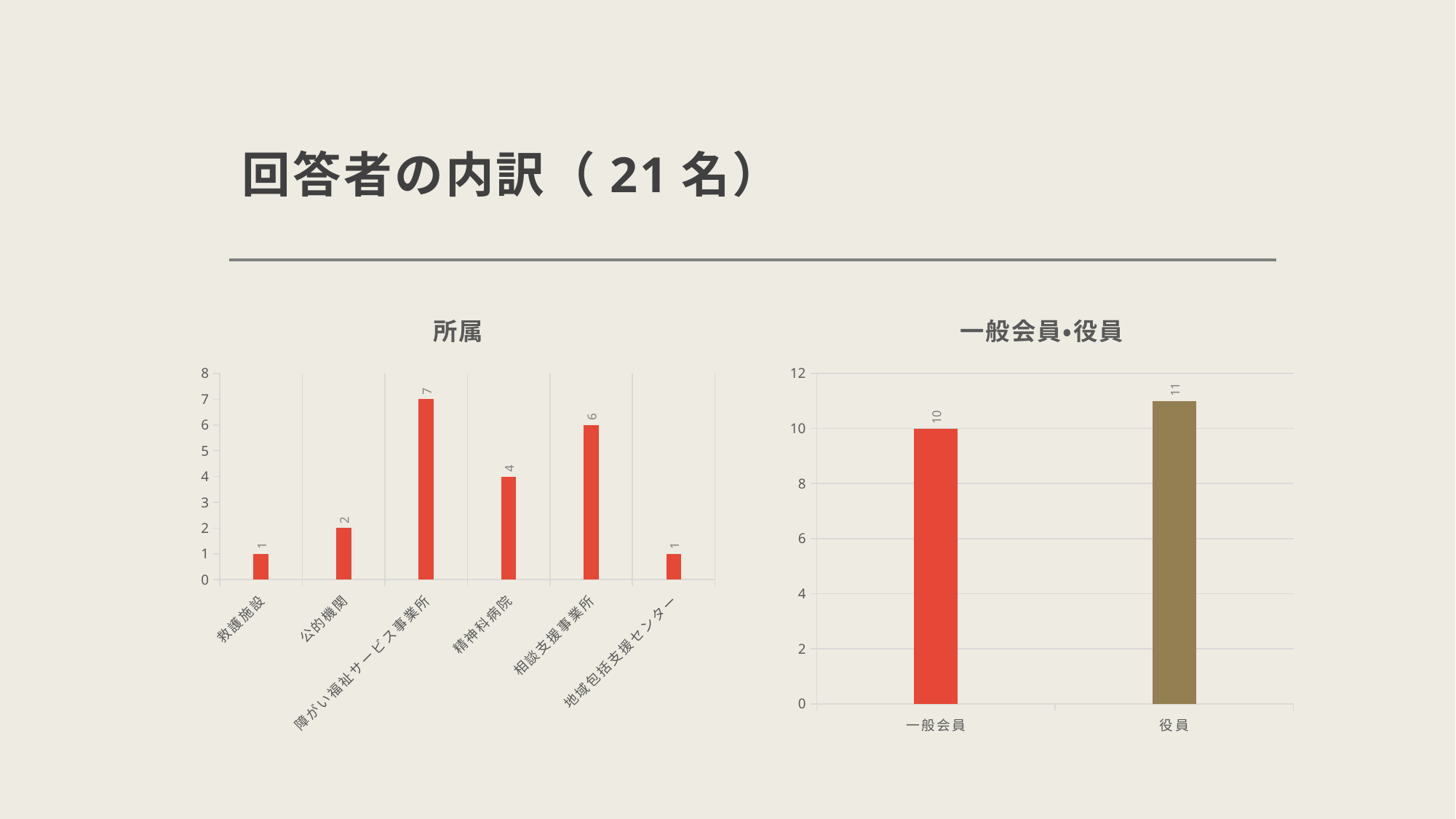
In the 所属 chart, what is the difference between 相談支援事業所 and 公的機関? 4 In the 一般会員•役員 chart, what is the value for 役員? 11 In the 所属 chart, which category has the highest value? 障がい福祉サービス事業所 In the 一般会員•役員 chart, what is the value for 一般会員? 10 What kind of chart is the 一般会員•役員 chart? Bar chart In the 所属 chart, which is larger, 精神科病院 or 相談支援事業所? 相談支援事業所 In the 所属 chart, what is the value for 公的機関? 2 In the 所属 chart, how many categories are shown? 6 In the 一般会員•役員 chart, what is the difference between 役員 and 一般会員? 1 What is the title of the chart on the left of the slide? 所属 In the 所属 chart, what is the value for 障がい福祉サービス事業所? 7 In the 所属 chart, what is the value for 精神科病院? 4